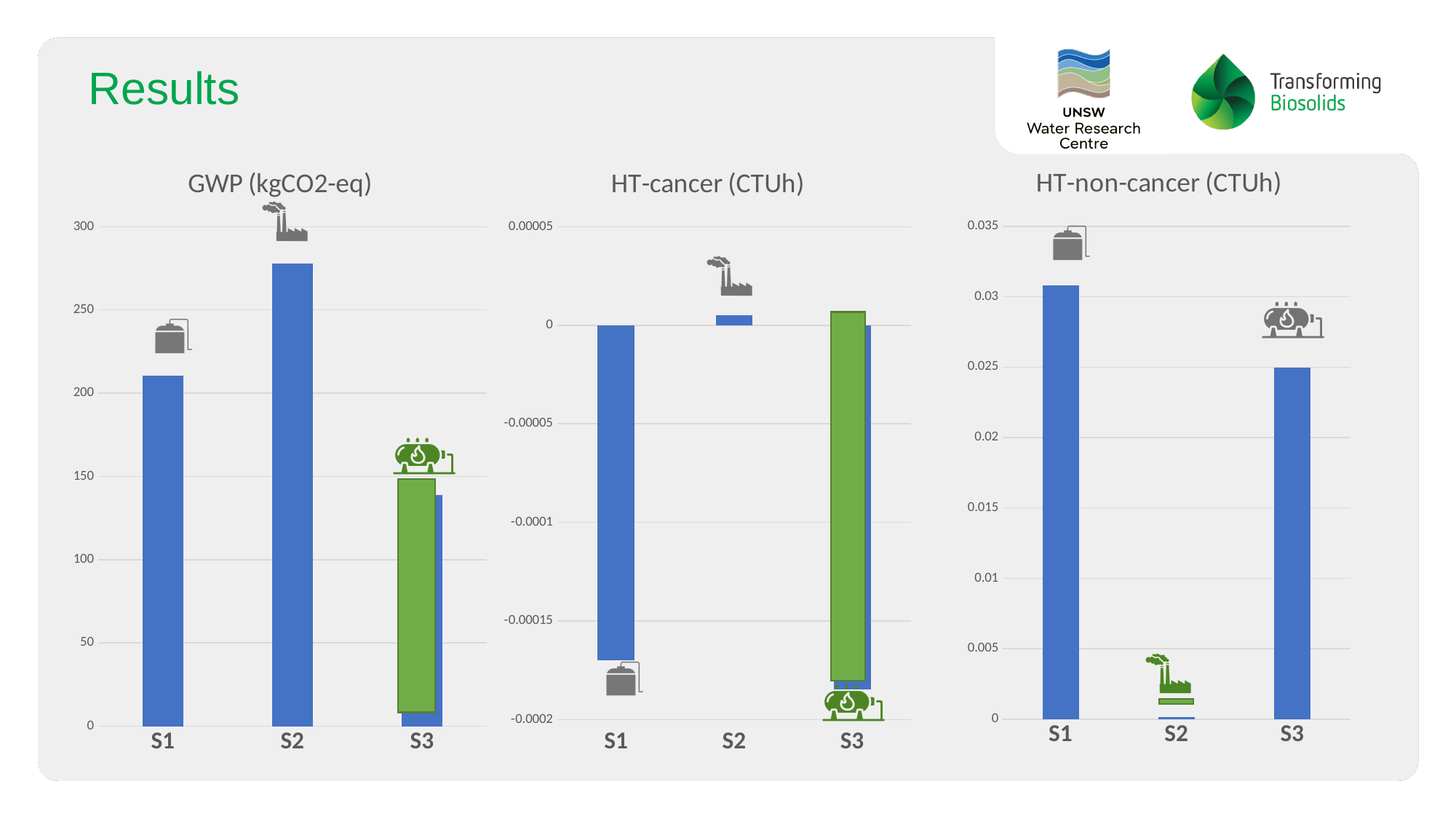
How many categories are shown on the x axis of the HT-non-cancer (CTUh) chart? 3 In the GWP (kgCO2-eq) chart, is the value for S2 greater or less than 250? greater In the GWP (kgCO2-eq) chart, is the value for S3 greater or less than 150? less In the HT-cancer (CTUh) chart, is the value for S1 greater or less than -0.00015? less In the GWP (kgCO2-eq) chart, which category has the lowest value? S3 In the HT-non-cancer (CTUh) chart, which category has the highest value? S1 In the GWP (kgCO2-eq) chart, which category has the highest value? S2 In the HT-non-cancer (CTUh) chart, which category has the lowest value? S2 What kind of chart is the GWP (kgCO2-eq) chart? bar chart In the HT-cancer (CTUh) chart, which category has the highest value? S2